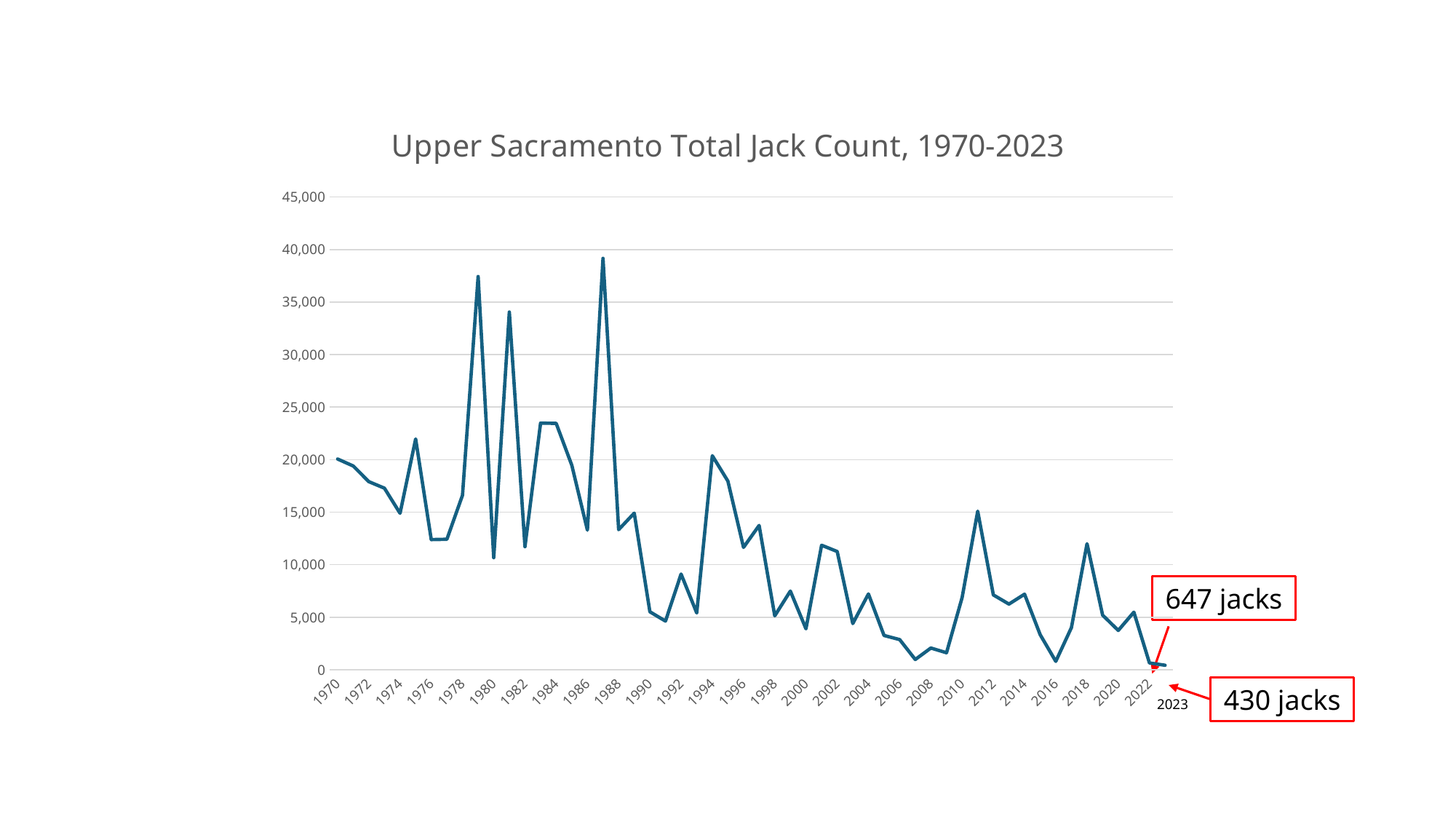
Overall, does the jack count rise or fall from 1970 to 2023? Fall What is the title of the chart? Upper Sacramento Total Jack Count, 1970-2023 Is the value for 1987 greater or less than 35,000? greater What is the difference between the 2022 and 2023 jack counts? 217 jacks Which year has the highest jack count on the chart? 1987 What is the jack count for 2022? 647 jacks Which year has the larger jack count, 2022 or 2023? 2022 What type of chart is shown on the slide? Line chart Is the value for 2007 greater or less than 5,000? less Is the value for 2010 greater or less than 10,000? less What is the jack count for 2023? 430 jacks Which year has the lowest jack count on the chart? 2023